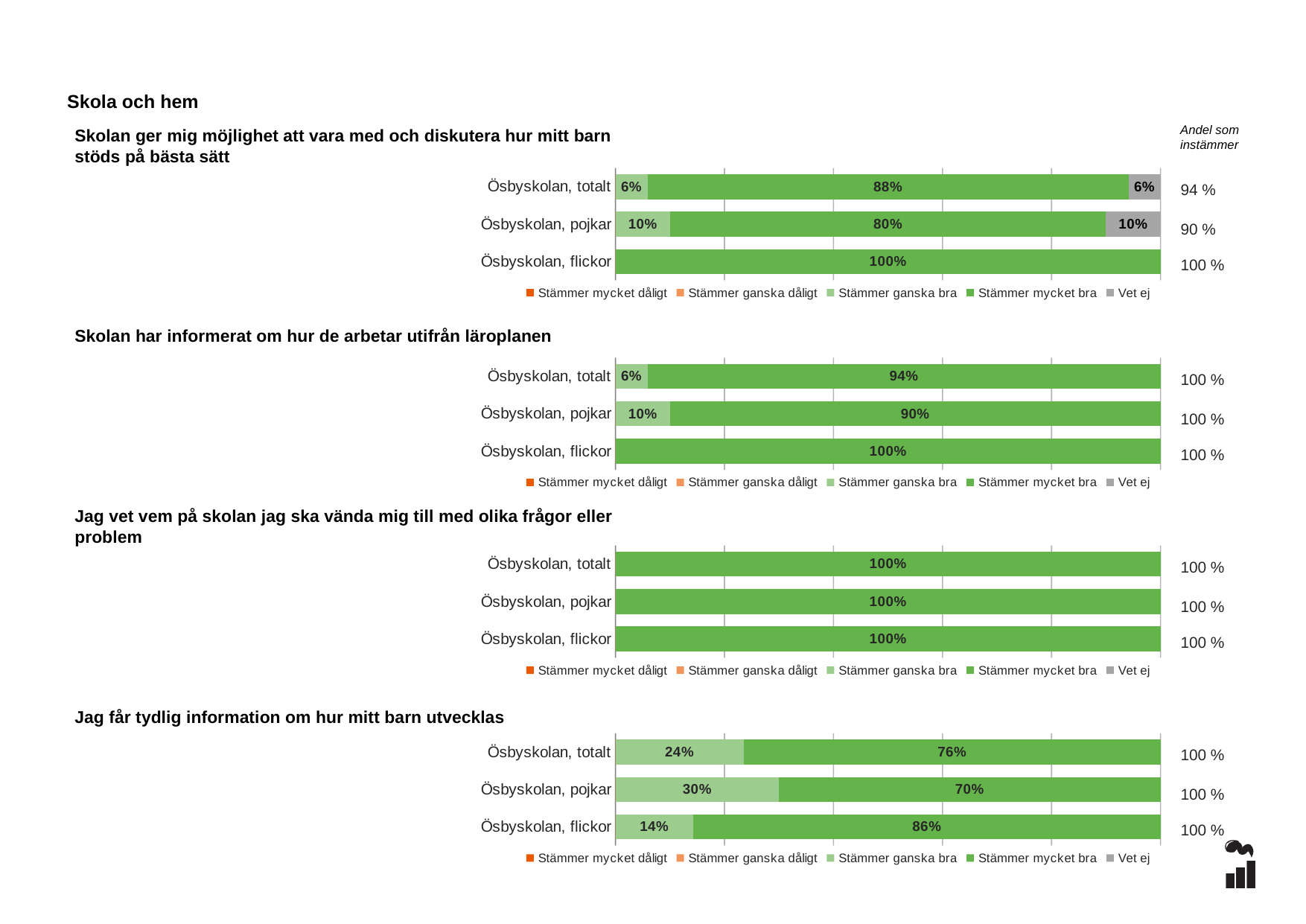
In the chart 'Skolan ger mig möjlighet att vara med och diskutera hur mitt barn stöds på bästa sätt', what is the 'Andel som instämmer' value for Ösbyskolan, pojkar? 90 % How many categories does the chart 'Jag vet vem på skolan jag ska vända mig till med olika frågor eller problem' show? 3 In the chart 'Skolan har informerat om hur de arbetar utifrån läroplanen', what is the 'Stämmer mycket bra' value for Ösbyskolan, pojkar? 90% In the chart 'Jag får tydlig information om hur mitt barn utvecklas', what is the difference between the 'Stämmer mycket bra' values for Ösbyskolan, flickor and Ösbyskolan, pojkar? 16% In the chart 'Skolan ger mig möjlighet att vara med och diskutera hur mitt barn stöds på bästa sätt', what is the 'Vet ej' value for Ösbyskolan, pojkar? 10% In the chart 'Jag får tydlig information om hur mitt barn utvecklas', what is the 'Stämmer ganska bra' value for Ösbyskolan, flickor? 14% In the chart 'Skolan har informerat om hur de arbetar utifrån läroplanen', which is larger: the 'Stämmer ganska bra' value for Ösbyskolan, totalt or for Ösbyskolan, pojkar? Ösbyskolan, pojkar In the chart 'Jag får tydlig information om hur mitt barn utvecklas', which category has the highest 'Stämmer mycket bra' value? Ösbyskolan, flickor How many series does the legend of the chart 'Skolan ger mig möjlighet att vara med och diskutera hur mitt barn stöds på bästa sätt' list? 5 What kind of chart is 'Jag får tydlig information om hur mitt barn utvecklas'? Stacked bar chart In the chart 'Skolan ger mig möjlighet att vara med och diskutera hur mitt barn stöds på bästa sätt', what is the 'Stämmer mycket bra' value for Ösbyskolan, totalt? 88% In the chart 'Jag får tydlig information om hur mitt barn utvecklas', which category has the lowest 'Stämmer mycket bra' value? Ösbyskolan, pojkar